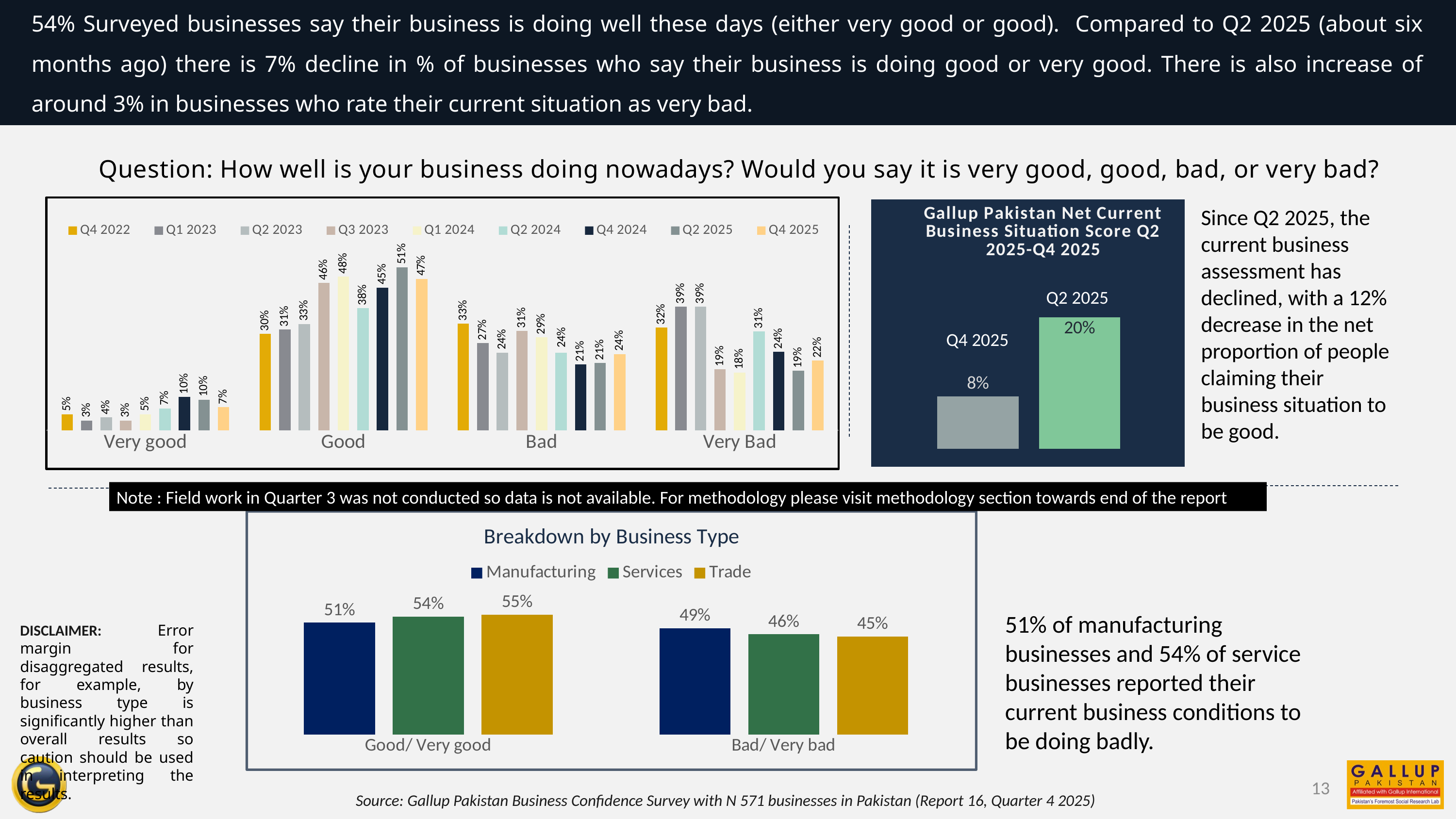
In the 'Breakdown by Business Type' chart, what percentage of Trade businesses reported Good/ Very good? 55% In the top-left chart of quarterly results, what is the Q4 2025 value for 'Very Bad'? 22% What type of chart is the 'Breakdown by Business Type' chart? Bar chart In the 'Breakdown by Business Type' chart, what is the Bad/ Very bad value for Manufacturing? 49% In the top-left chart of quarterly results, which quarter has the highest value for 'Good'? Q2 2025 In the 'Gallup Pakistan Net Current Business Situation Score Q2 2025-Q4 2025' chart, what is the difference between the Q2 2025 and Q4 2025 values? 12% In the top-left chart of quarterly results, what is the Q4 2025 value for 'Good'? 47% In the top-left chart of quarterly results, how many quarters does the legend list? 9 In the 'Breakdown by Business Type' chart, what is the difference between the Services values for Good/ Very good and Bad/ Very bad? 8% In the 'Breakdown by Business Type' chart, how many series does the legend list? 3 In the 'Gallup Pakistan Net Current Business Situation Score Q2 2025-Q4 2025' chart, what is the value for Q4 2025? 8% In the 'Gallup Pakistan Net Current Business Situation Score Q2 2025-Q4 2025' chart, which quarter has the higher score? Q2 2025